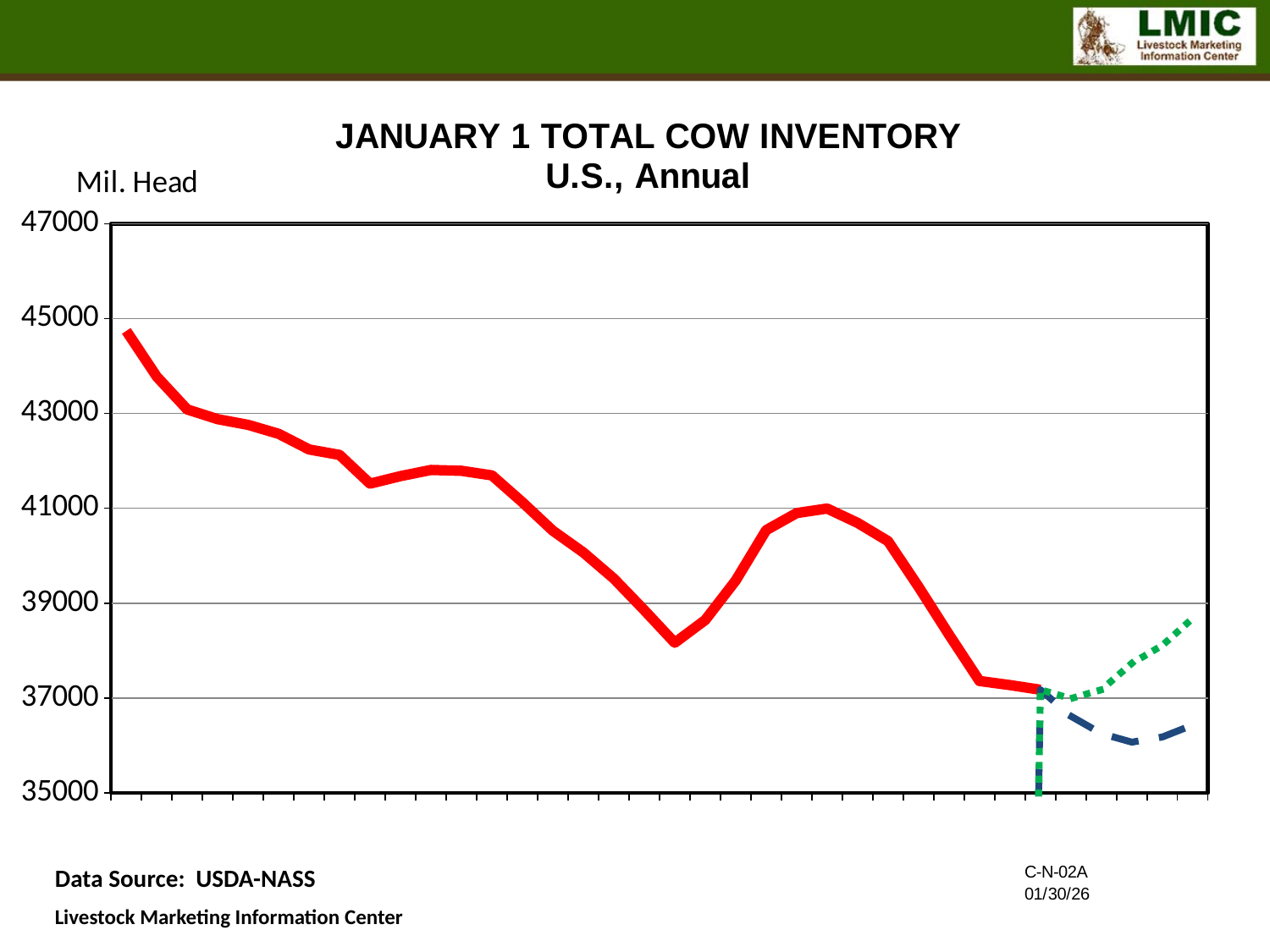
At the right edge of the chart, which ends higher: the green dotted line or the blue dashed line? green dotted line Is the value at the left-hand start of the solid red line greater or less than 43000? greater Overall, does the solid red line rise or fall from left to right? fall Is the value at the right-hand end of the blue dashed line greater or less than 37000? less Is the value at the right-hand end of the solid red line greater or less than 39000? less Does the green dotted line at the right of the chart rise or fall from left to right? rise What kind of chart is shown on the slide? line chart What unit label is shown above the vertical axis? Mil. Head What is the title of the chart? JANUARY 1 TOTAL COW INVENTORY U.S., Annual